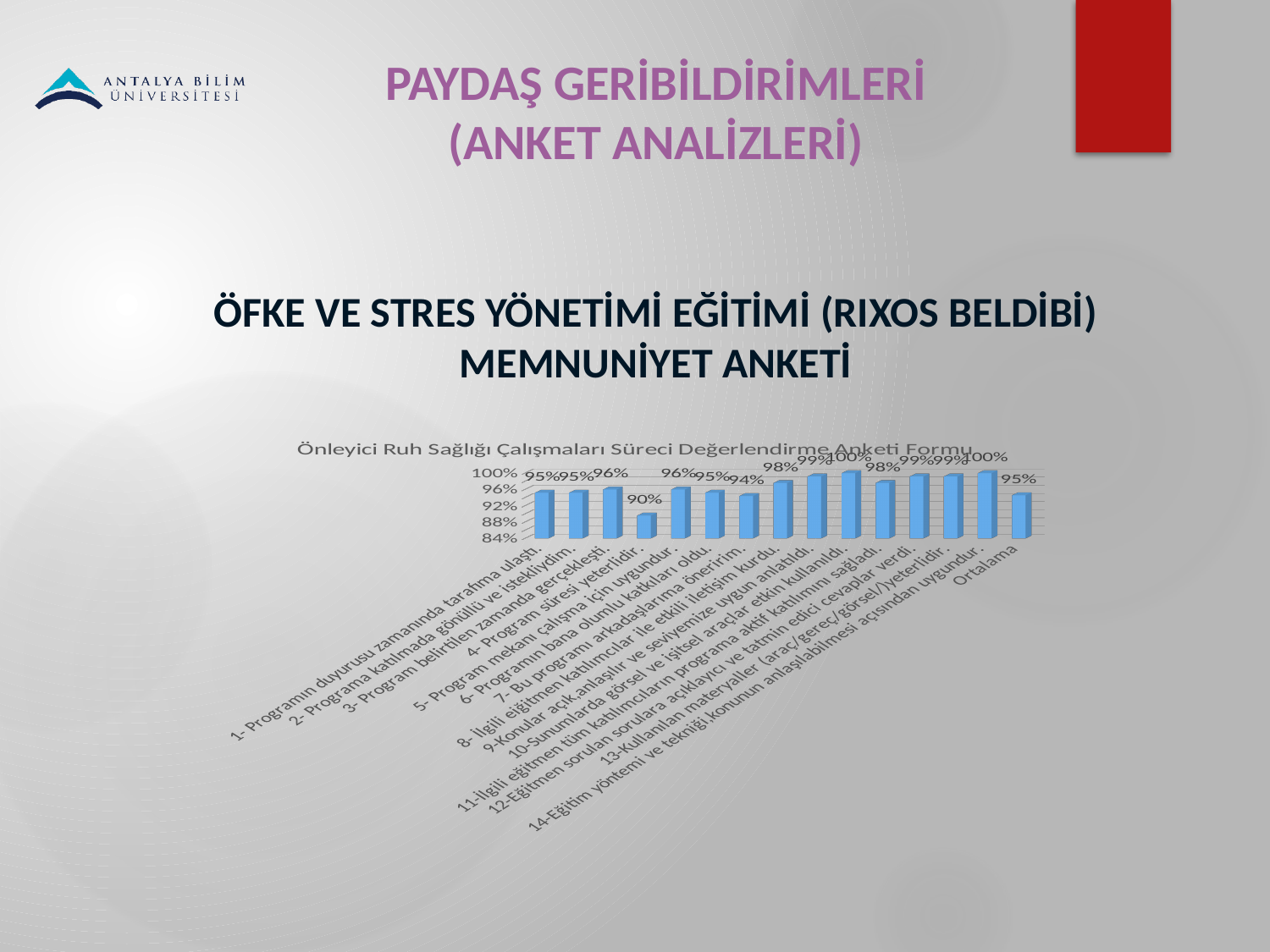
What is the difference between the value for item 10 (Sunumlarda görsel ve işitsel araçlar etkin kullanıldı) and item 4 (Program süresi yeterlidir)? 10 percentage points What is the value for "Ortalama" in the chart? 95% Which is larger: the value for "4- Program süresi yeterlidir." or the value for "9-Konular açık,anlaşılır ve seviyemize uygun anlatıldı."? 9-Konular açık,anlaşılır ve seviyemize uygun anlatıldı. What is the value for "8- İlgili eğitmen katılımcılar ile etkili iletişim kurdu."? 98% What is the value for "10-Sunumlarda görsel ve işitsel araçlar etkin kullanıldı."? 100% What is the title of the chart? Önleyici Ruh Sağlığı Çalışmaları Süreci Değerlendirme Anketi Formu What is the value for "7- Bu programı arkadaşlarıma öneririm."? 94% Is the value for "4- Program süresi yeterlidir." greater or less than 92%? less What kind of chart is shown on the slide? bar chart How many bars are plotted in the chart? 15 Which category has the lowest value in the chart? 4- Program süresi yeterlidir. What is the value for "4- Program süresi yeterlidir."? 90%